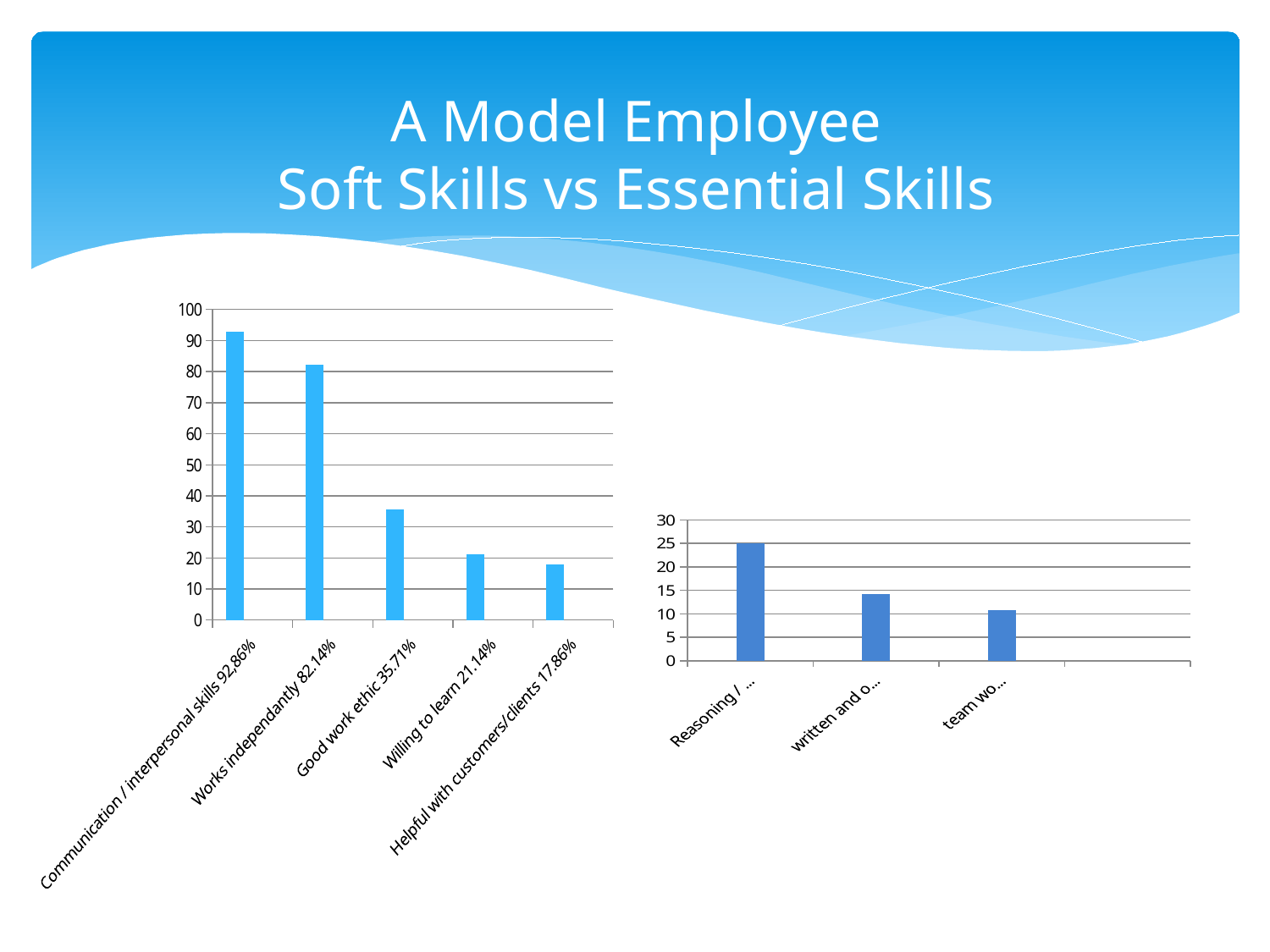
On the left chart, which category has the highest bar? Communication / interpersonal skills On the left chart, how many categories are plotted? 5 What kind of chart is the chart on the right of the slide? bar chart On the right chart, is the value of the third bar greater or less than 15? less On the left chart, what value is shown for Communication / interpersonal skills? 92,86% On the left chart, which is larger: Good work ethic or Willing to learn? Good work ethic On the left chart, do the bar values rise or fall from left to right? fall On the left chart, what value is shown for Good work ethic? 35.71% On the left chart, which category has the lowest bar? Helpful with customers/clients On the left chart, what is the difference between the values for Works independantly and Willing to learn? 61% On the right chart, is the value of the first (leftmost) bar greater or less than 20? greater On the left chart, what value is shown for Helpful with customers/clients? 17.86%